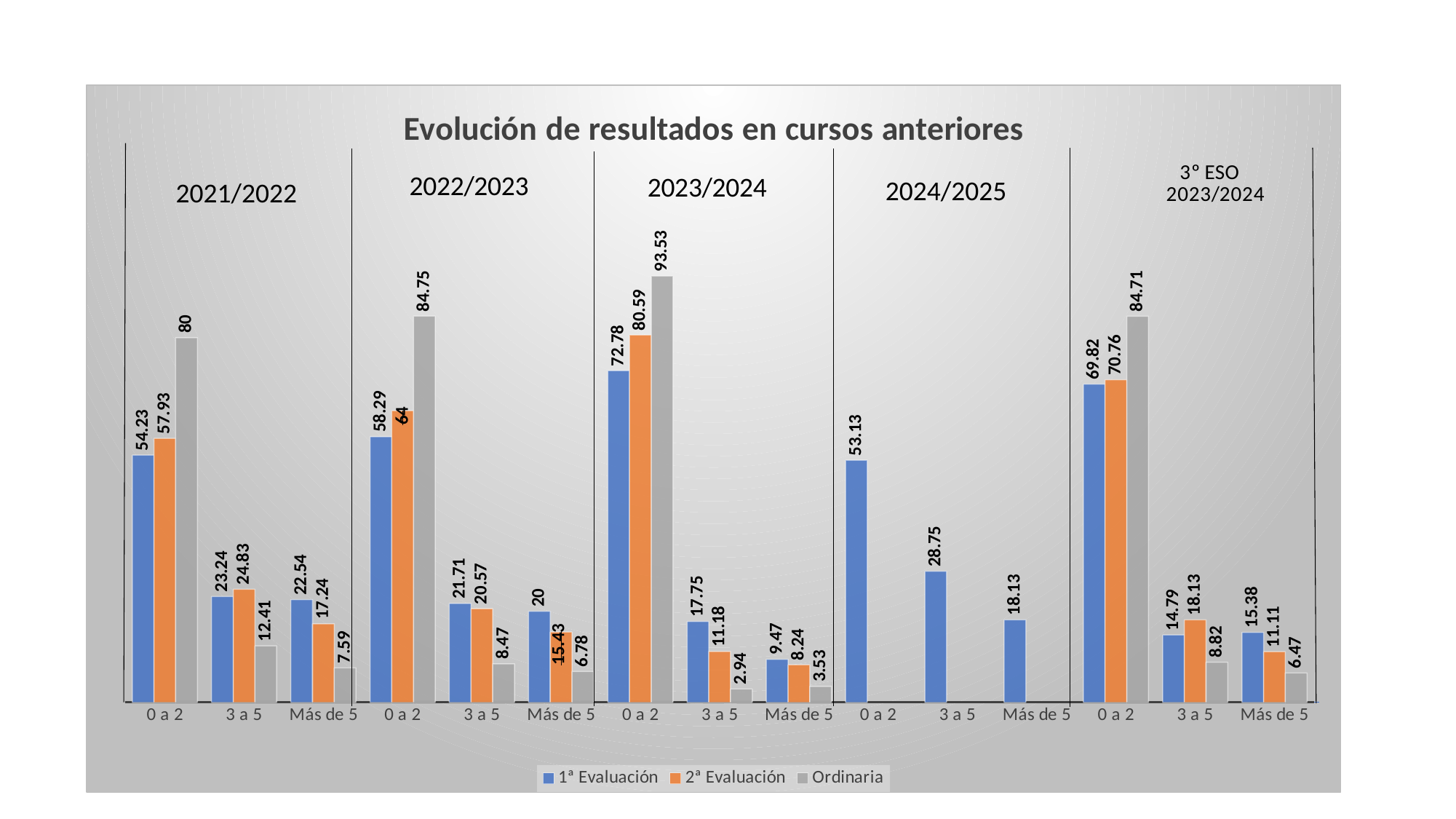
For '0 a 2' in the 3º ESO 2023/2024 group, which is larger: 1ª Evaluación or 2ª Evaluación? 2ª Evaluación Which bar in the whole chart has the highest value? Ordinaria, 0 a 2, 2023/2024 (93.53) What kind of chart is shown on the slide? Bar chart How many series have bars shown for the 2024/2025 group? 1 How many series does the legend list? 3 What is the 2ª Evaluación value for 'Más de 5' in 2022/2023? 15.43 Which bar in the whole chart has the lowest value? Ordinaria, 3 a 5, 2023/2024 (2.94) What is the title of the chart? Evolución de resultados en cursos anteriores What is the 1ª Evaluación value for '0 a 2' in 2024/2025? 53.13 What is the Ordinaria value for '0 a 2' in 2021/2022? 80 What is the difference between the Ordinaria value and the 1ª Evaluación value for '0 a 2' in 2022/2023? 26.46 Which series is shown in orange in the legend? 2ª Evaluación